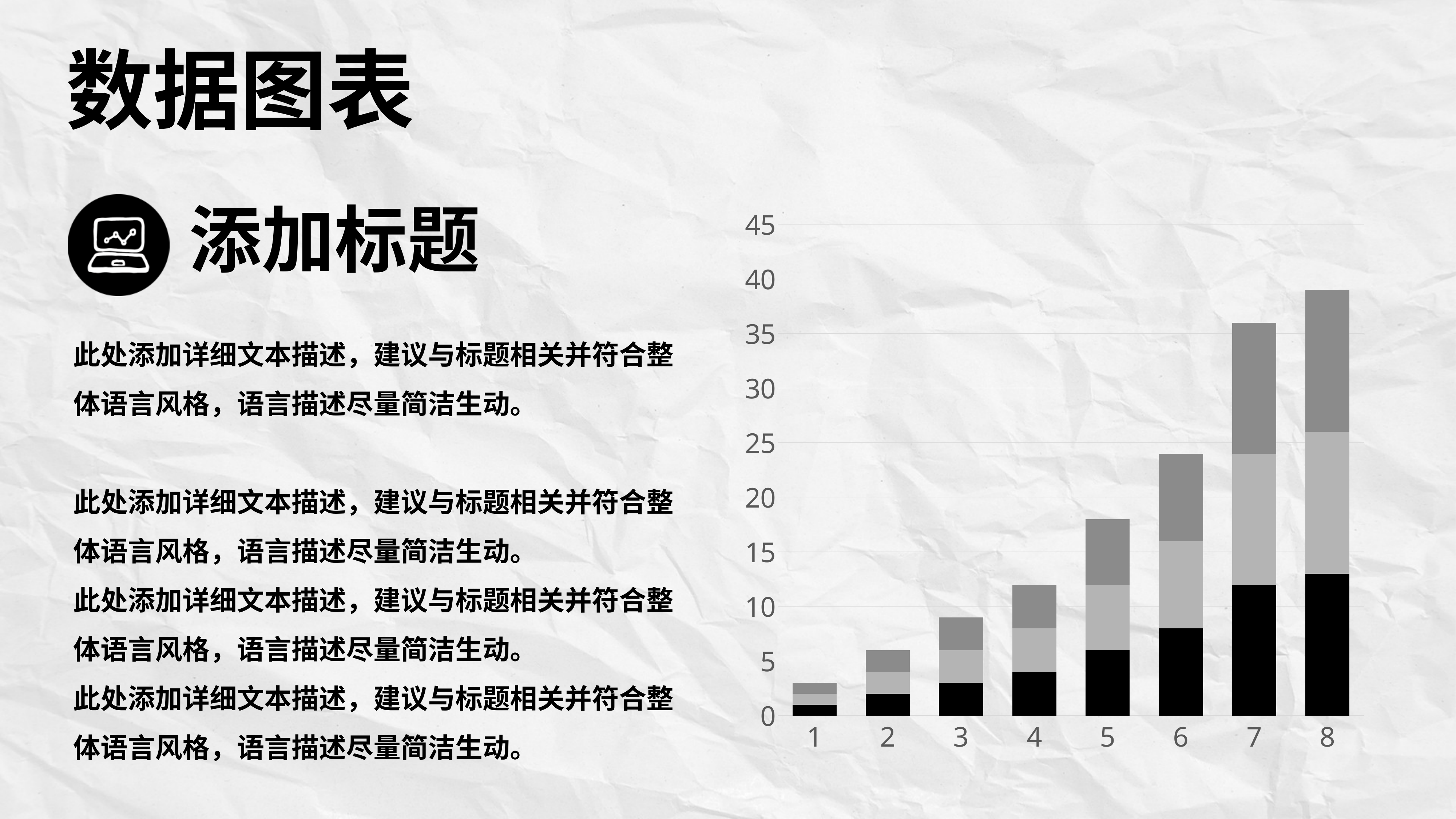
Which category has the shortest stacked bar? 1 How many categories are shown on the x axis of the chart? 8 Which stacked bar is taller, category 6 or category 7? 7 How many stacked segments does each bar in the chart have? 3 Which stacked bar is taller, category 4 or category 5? 5 Do the stacked bar totals rise or fall from category 1 to category 8? rise Is the total of the stacked bar for category 8 greater or less than 35? greater What kind of chart is shown on the slide? bar chart Which category has the tallest stacked bar? 8 Is the total of the stacked bar for category 5 greater or less than 20? less Is the total of the stacked bar for category 4 greater or less than 10? greater